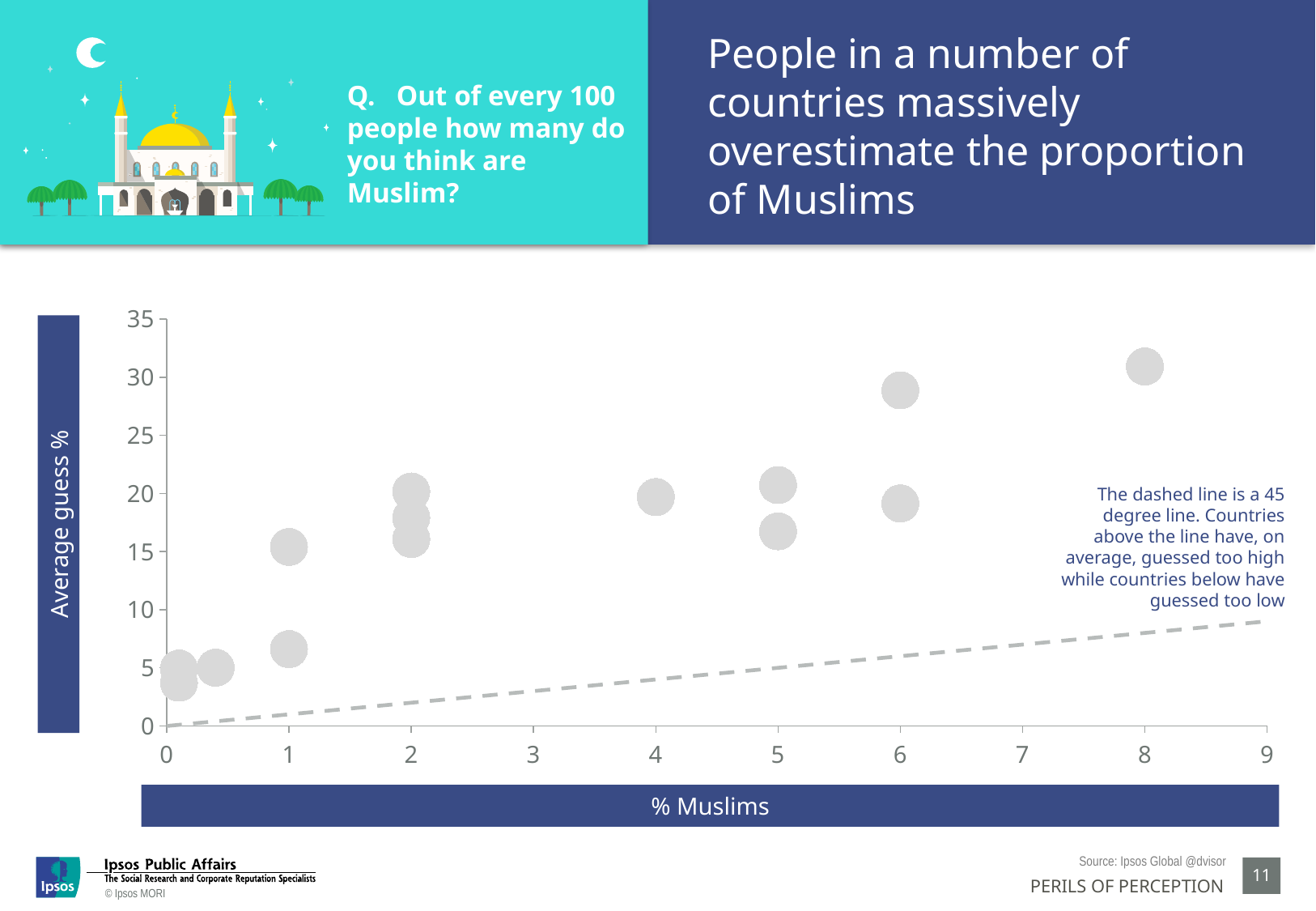
Is the average guess for the lowest point at 6% Muslims greater or less than 25? less Is the average guess for the point at 4% Muslims greater or less than 15? greater What is the title of the vertical axis of the chart? Average guess % Is the average guess for the point at 4% Muslims greater or less than 25? less At which % Muslims value does the point with the highest average guess appear? 8 What kind of chart is shown on the slide? Scatter chart Are all the plotted points above or below the dashed 45 degree line? above What is the title of the horizontal axis of the chart? % Muslims Do the average guesses generally rise or fall as the % Muslims increases along the x axis? rise